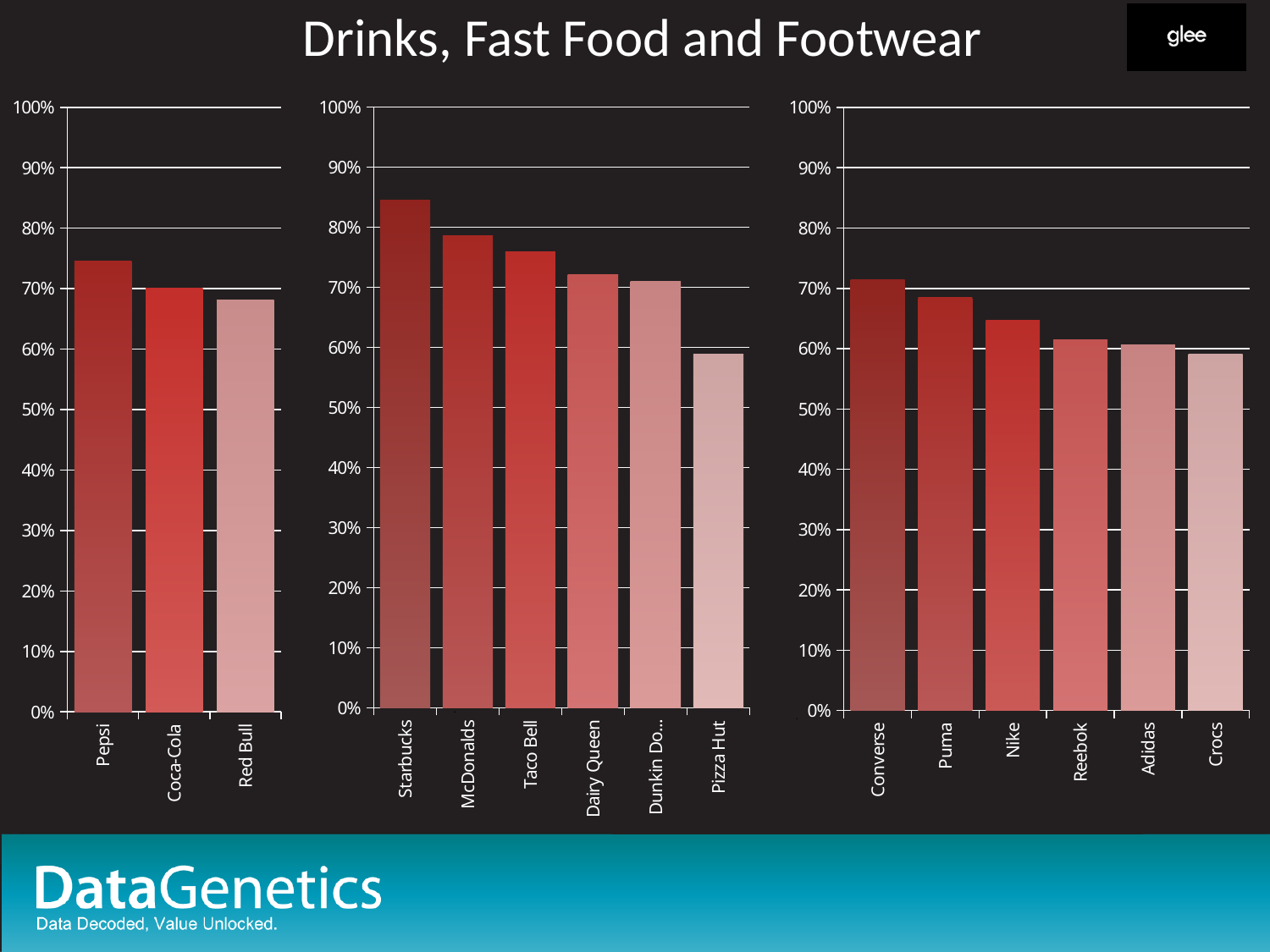
In the left chart (Pepsi, Coca-Cola, Red Bull), is the value for Pepsi greater or less than 70%? greater What kind of chart is the right chart (Converse to Crocs)? bar chart In the middle chart (Starbucks to Pizza Hut), is the value for Pizza Hut greater or less than 60%? less In the right chart (Converse to Crocs), which is larger, the value for Nike or the value for Reebok? Nike In the right chart (Converse to Crocs), which category has the highest value? Converse In the middle chart (Starbucks to Pizza Hut), which category has the highest value? Starbucks In the left chart (Pepsi, Coca-Cola, Red Bull), how many categories are plotted? 3 In the middle chart (Starbucks to Pizza Hut), how many categories are plotted? 6 In the middle chart (Starbucks to Pizza Hut), which category has the lowest value? Pizza Hut In the left chart (Pepsi, Coca-Cola, Red Bull), which category has the highest value? Pepsi In the right chart (Converse to Crocs), do the values rise or fall from left to right along the x axis? fall In the middle chart (Starbucks to Pizza Hut), is the value for Starbucks greater or less than 80%? greater